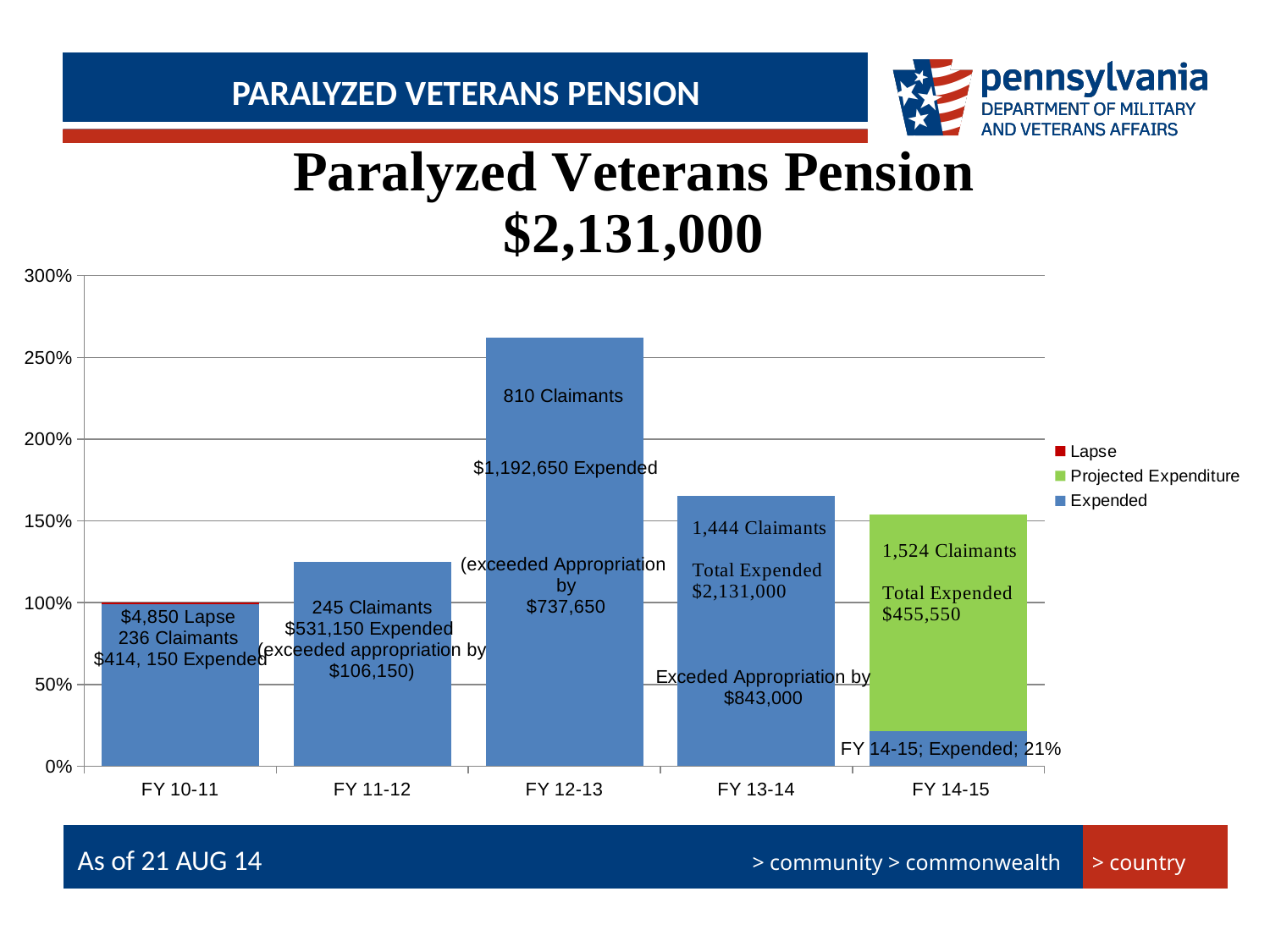
Is the total bar height for FY 13-14 greater or less than 150%? greater Which colour represents Projected Expenditure in the legend? green How many fiscal year categories are shown on the x axis? 5 What lapse amount is labeled for FY 10-11? $4,850 How many series does the legend list? 3 What amount was expended in FY 11-12 according to the bar label? $531,150 Which fiscal year has the shortest bar? FY 10-11 What is the Expended percentage labeled for FY 14-15? 21% What is the difference in claimants between FY 13-14 (1,444) and FY 12-13 (810)? 634 How many claimants are labeled for FY 12-13? 810 Claimants What kind of chart is shown on the slide? bar chart Which fiscal year has the tallest bar? FY 12-13